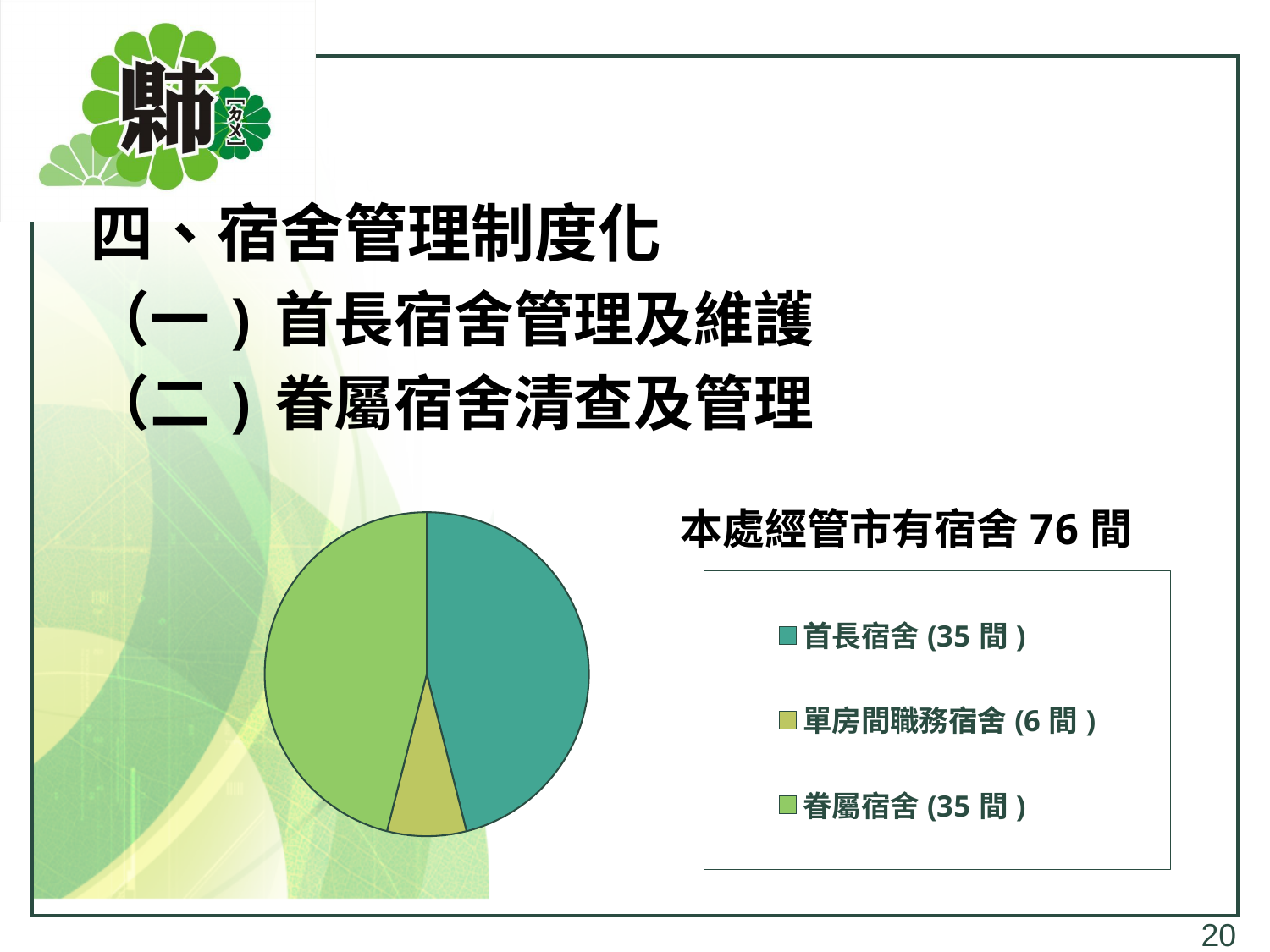
How many rooms does the legend give for 眷屬宿舍? 35 間 How many entries does the legend of the pie chart list? 3 Which is larger, 首長宿舍 or 單房間職務宿舍? 首長宿舍 How many rooms does the legend give for 單房間職務宿舍? 6 間 How many slices does the pie chart have? 3 How many rooms does the legend give for 首長宿舍? 35 間 Which legend entry is shown in the teal colour? 首長宿舍 (35 間) What text appears above the legend of the pie chart? 本處經管市有宿舍 76 間 Which category has the smallest slice in the pie chart? 單房間職務宿舍 What kind of chart is shown on the slide? pie chart What is the total number of dormitory rooms shown for the pie chart? 76 間 What is the difference in rooms between 眷屬宿舍 and 單房間職務宿舍? 29 間